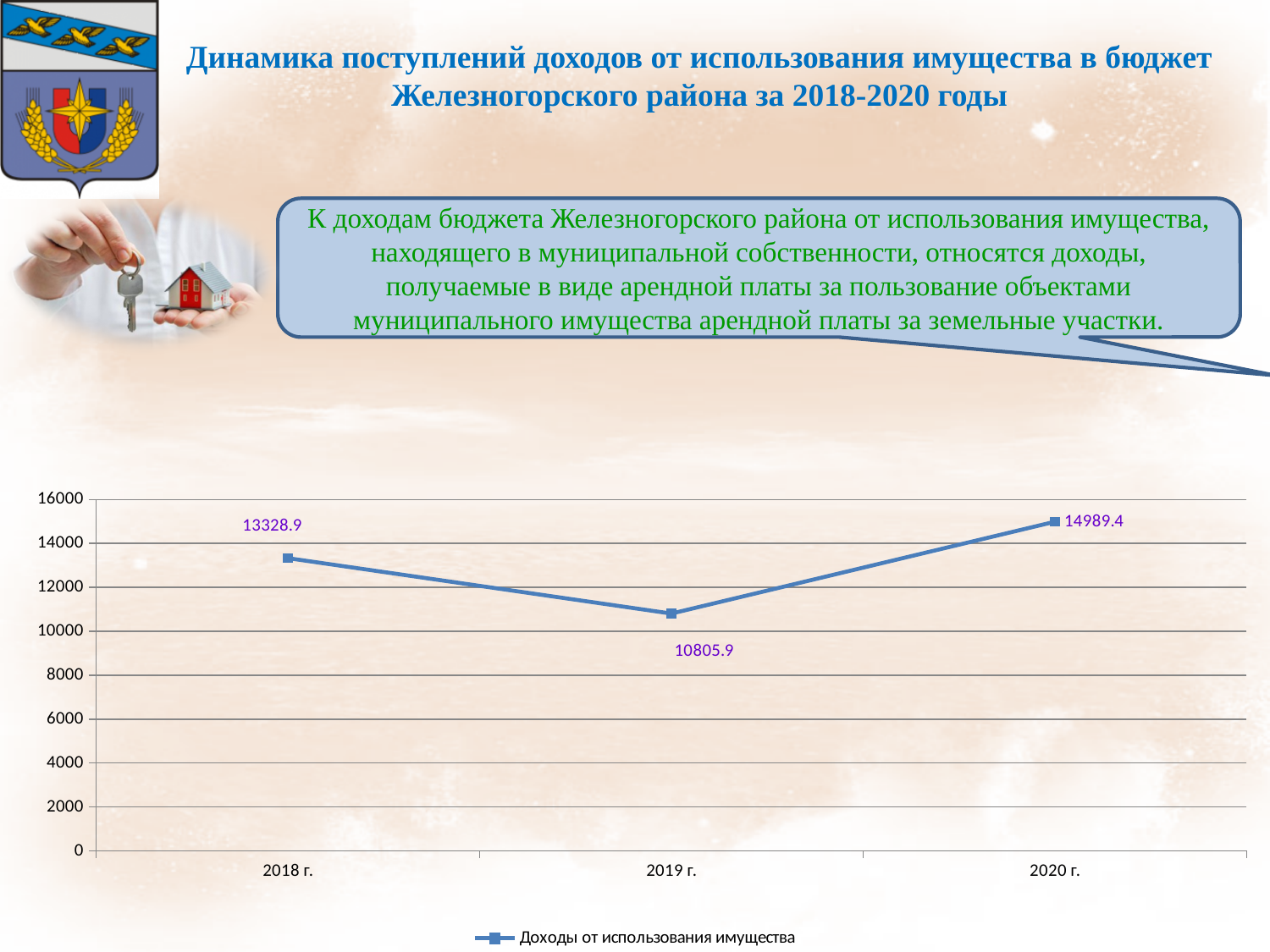
Which year has the highest value? 2020 г. How many years are plotted on the chart? 3 Is the value for 2019 г. greater or less than 12000? less Which year has the lowest value? 2019 г. Which is larger, the value for 2018 г. or the value for 2019 г.? 2018 г. What is the difference between the values for 2020 г. and 2018 г.? 1660.5 What is the value for 2019 г.? 10805.9 What is the difference between the values for 2018 г. and 2019 г.? 2523.0 What is the value for 2018 г.? 13328.9 What kind of chart is shown on the slide? line chart What is the value for 2020 г.? 14989.4 What series name does the legend show? Доходы от использования имущества